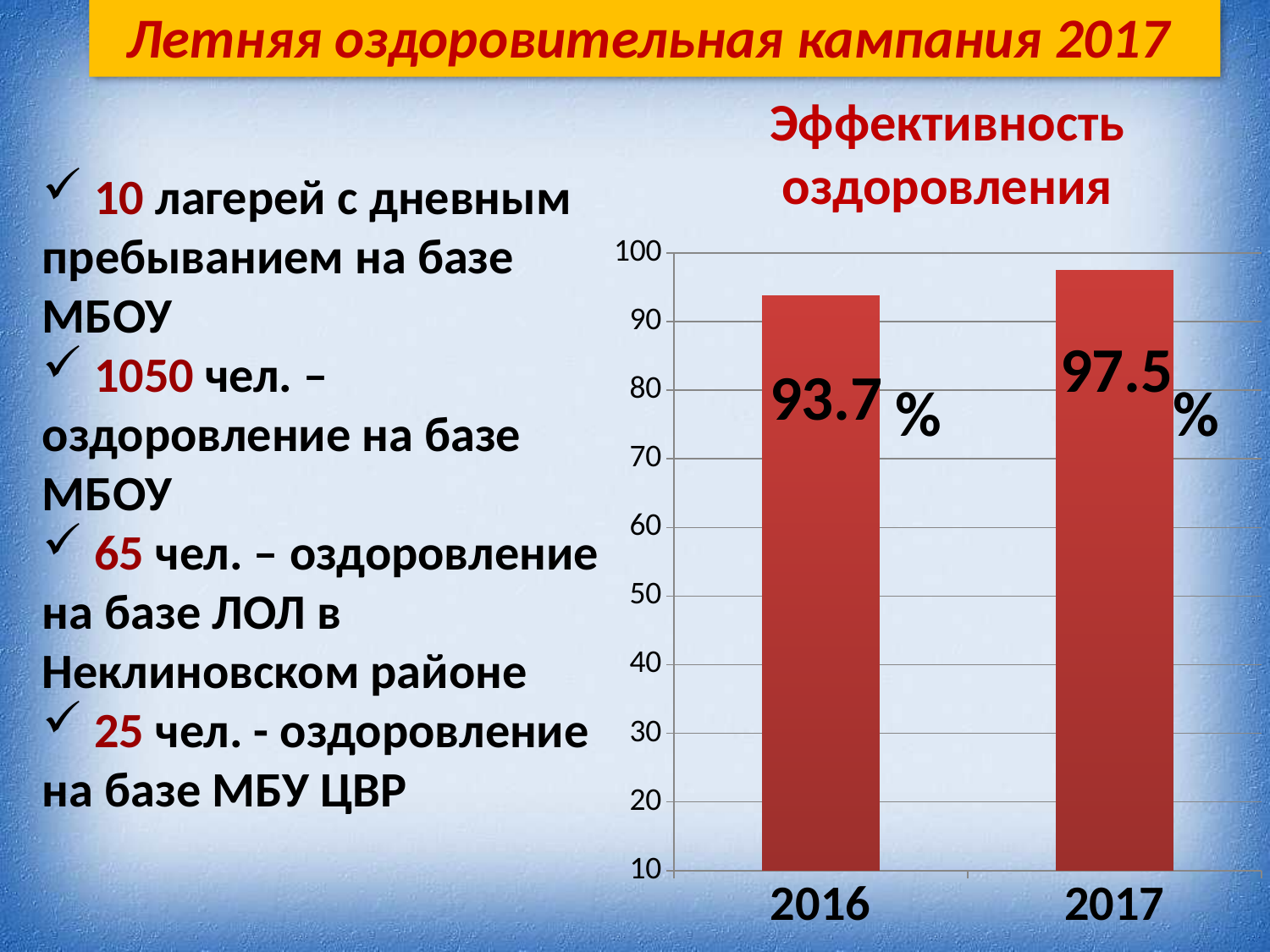
What is the difference between the 2017 and 2016 values? 3.8 % Which year has the higher value in the chart? 2017 Which year has the lower value in the chart? 2016 What is the value for 2017 in the chart? 97.5 % How many categories are shown on the x axis of the chart? 2 What is the title of the chart? Эффективность оздоровления What colour are the bars in the chart? red Do the values rise or fall from 2016 to 2017? rise Is the value for 2016 greater or less than 90? greater What is the value for 2016 in the chart? 93.7 % What kind of chart is shown on the slide? bar chart Is the value for 2016 larger or smaller than the value for 2017? smaller